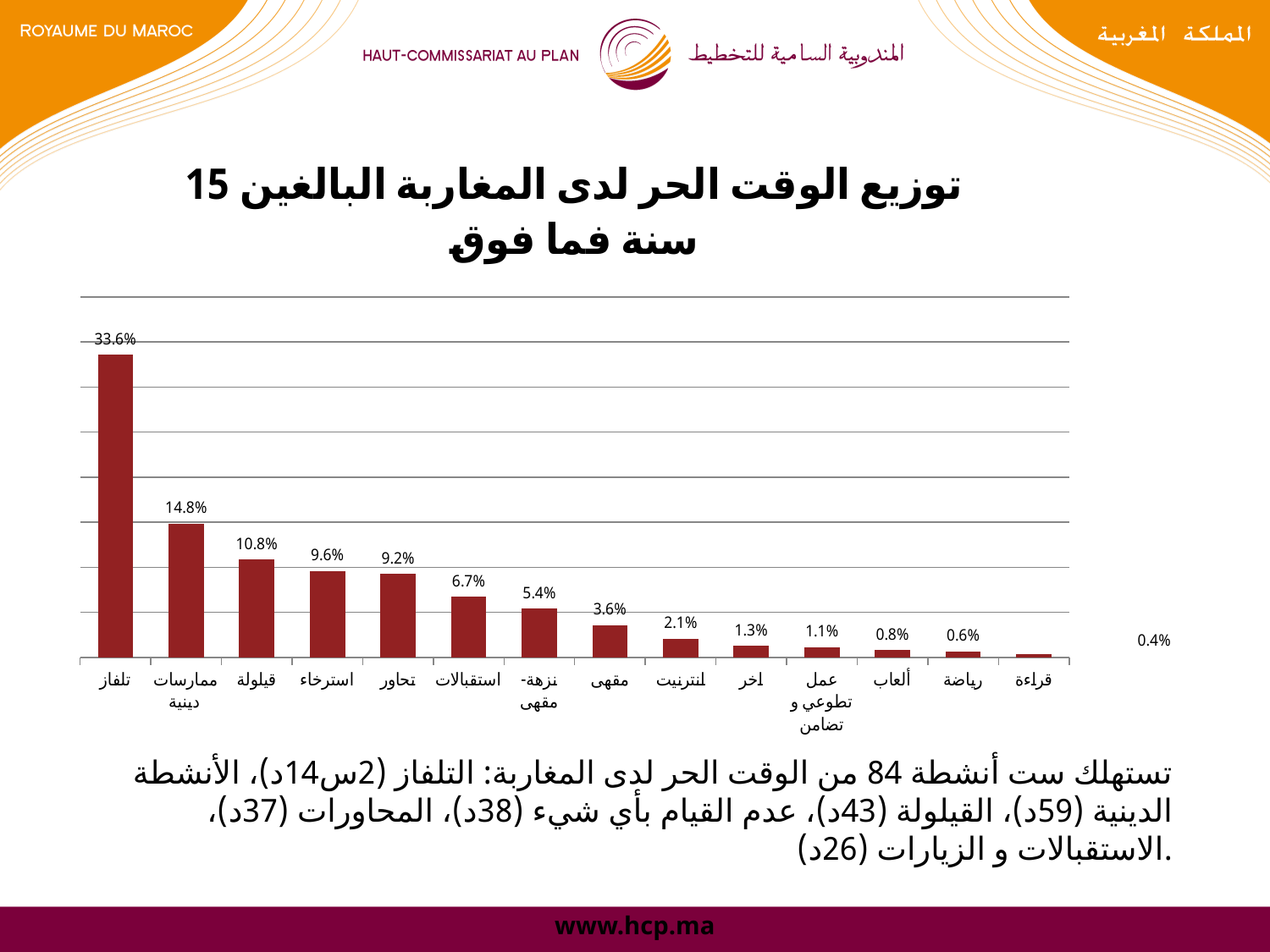
What is the value for تلفاز? 33.6% What is the difference between the values for تلفاز and ممارسات دينية? 18.8% What is the difference between the values for مقهى and لنترنيت? 1.5% Which category has the lowest value? قراءة How many categories are shown in the chart? 14 Do the values rise or fall from left to right along the x axis? fall What is the value for استقبالات? 6.7% Which category has the highest value? تلفاز What is the value for قيلولة? 10.8% What kind of chart is shown on the slide? bar chart What is the value for قراءة? 0.4% Which is larger, the value for استرخاء or the value for تحاور? استرخاء